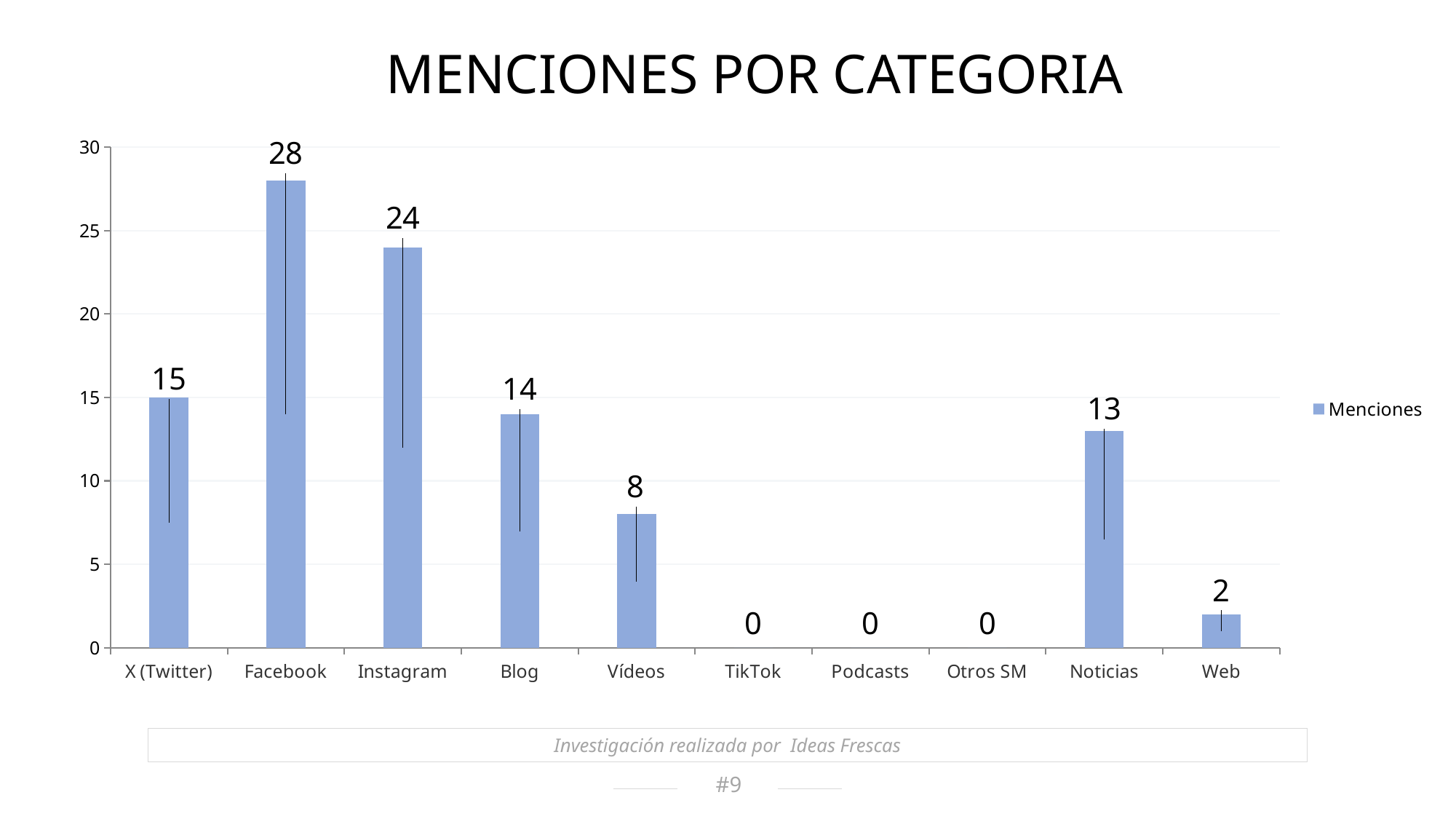
Which is larger, the value for Blog or the value for Vídeos? Blog How many categories are shown on the x axis? 10 Which category has the highest non-zero value after Facebook? Instagram What is the difference between the values for X (Twitter) and Web? 13 Is the value for Instagram greater or less than 20? greater What is the value for Instagram? 24 What is the value for Noticias? 13 Which category has the highest value? Facebook What kind of chart is shown? bar chart What is the difference between the values for Facebook and Instagram? 4 How many series does the legend list? 1 What is the value for Facebook? 28